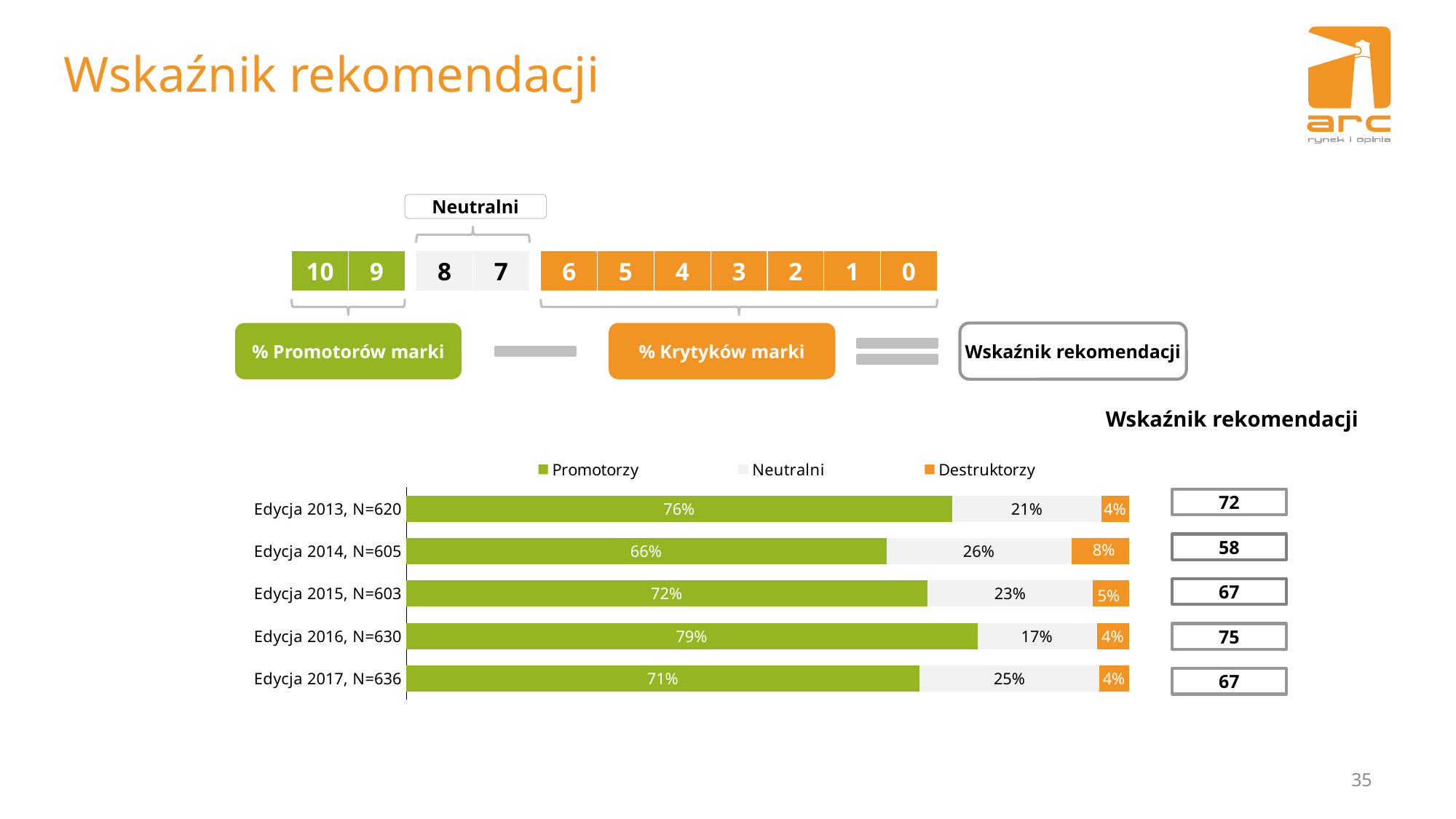
Which edition has the lowest Promotorzy value? Edycja 2014, N=605 What is the Wskaźnik rekomendacji value shown for Edycja 2014, N=605? 58 Which edition has the highest Destruktorzy value? Edycja 2014, N=605 What is the difference between the Promotorzy values for Edycja 2016, N=630 and Edycja 2014, N=605? 13% How many editions are shown in the bar chart? 5 How many series does the legend list? 3 What is the Promotorzy value for Edycja 2016, N=630? 79% Which is larger, the Neutralni value for Edycja 2017, N=636 or for Edycja 2013, N=620? Edycja 2017, N=636 What is the Neutralni value for Edycja 2014, N=605? 26% Which edition has the highest Promotorzy value? Edycja 2016, N=630 What is the Destruktorzy value for Edycja 2015, N=603? 5% What kind of chart is shown on the slide? Stacked bar chart